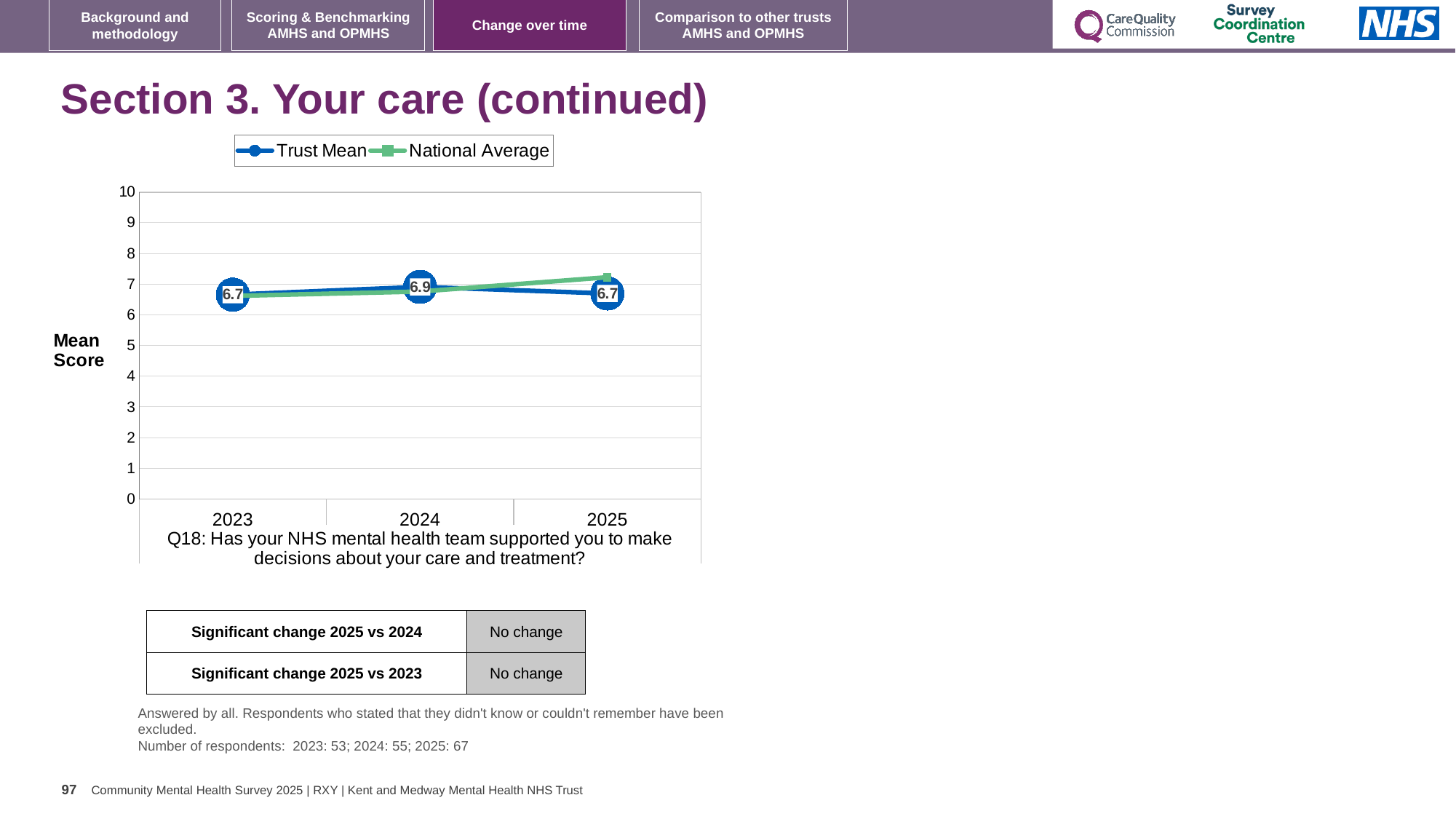
What is the difference between the Trust Mean score in 2024 and in 2023? 0.2 What is the Trust Mean score for 2025? 6.7 In 2025, which is higher: the Trust Mean or the National Average? National Average In which year is the Trust Mean score highest? 2024 Is the National Average value for 2025 greater or less than 7? greater What is the label on the y axis of the chart? Mean Score What is the Trust Mean score for 2023? 6.7 What is the Trust Mean score for 2024? 6.9 How many years are plotted on the x axis? 3 How many series does the legend list? 2 Is the National Average value for 2023 greater or less than 7? less What kind of chart is shown on the slide? Line chart